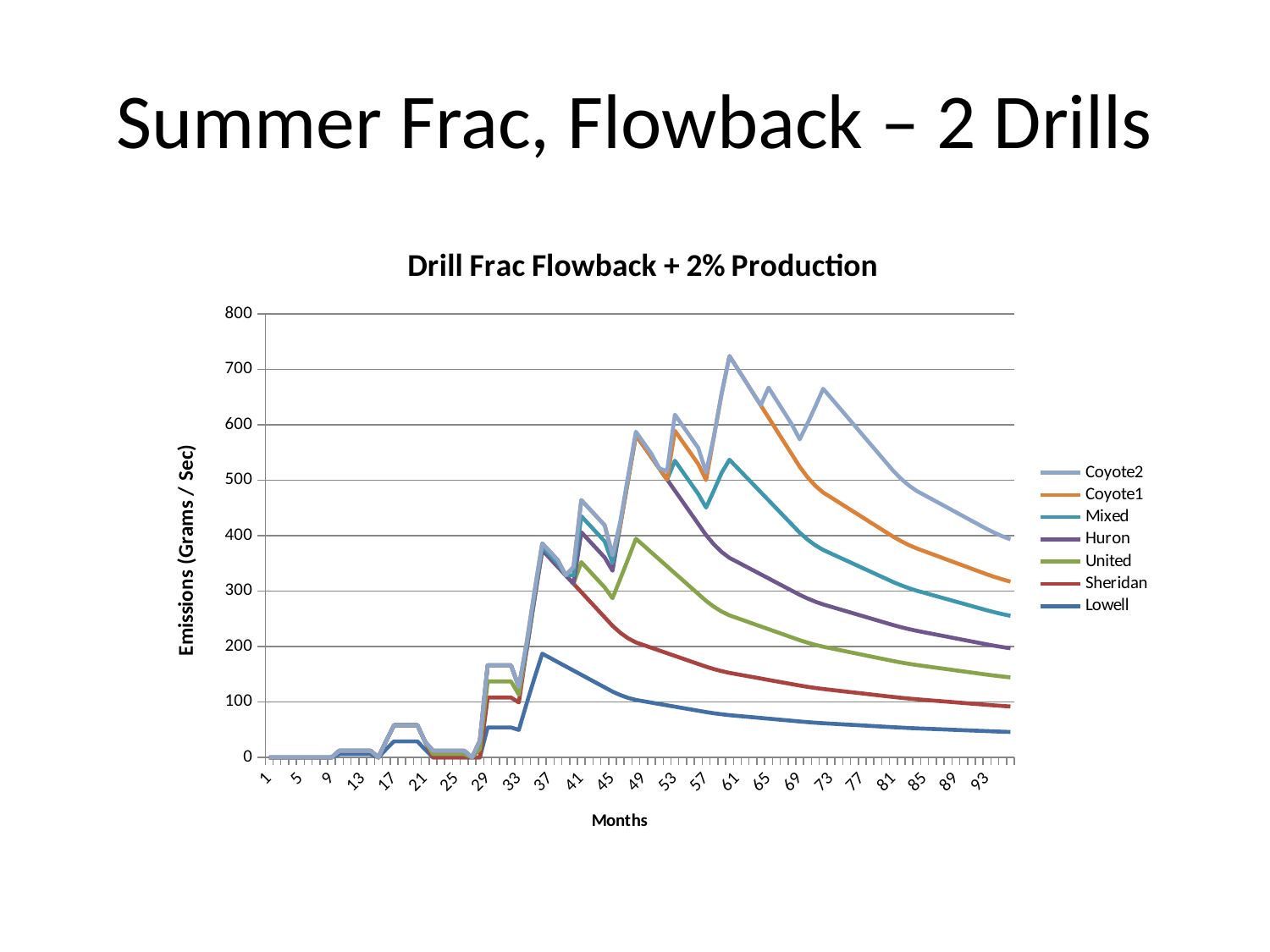
What is the label on the vertical axis of the chart? Emissions (Grams / Sec) Is the peak value of the Coyote2 series greater or less than 600? greater What kind of chart is shown on the slide? line chart Which series has the lowest value at the right end of the chart (around month 93)? Lowell Which series reaches the highest peak value on the chart? Coyote2 How many series does the legend list? 7 What is the title of the chart? Drill Frac Flowback + 2% Production Is the value for Huron at month 93 greater or less than 300? less At month 93, which series has the larger value, Coyote1 or Mixed? Coyote1 Is the value for Lowell at month 93 greater or less than 100? less Does the Lowell series rise or fall between month 37 and month 93? fall